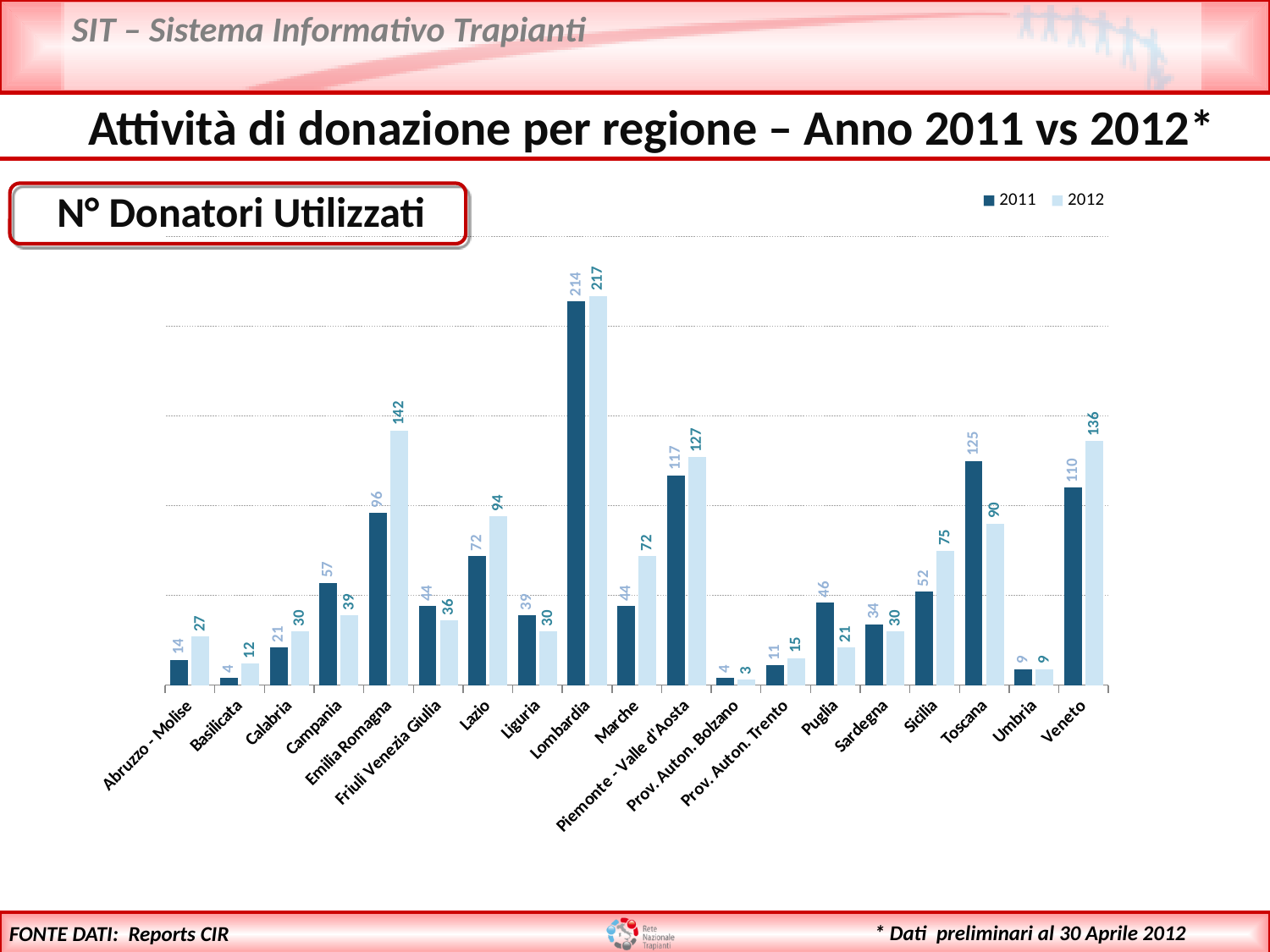
Which is larger for Sicilia, the 2011 value or the 2012 value? 2012 What is the difference between the 2012 and 2011 values for Veneto? 26 Which region has the highest 2012 value? Lombardia What is the 2012 value for Emilia Romagna? 142 How many series does the legend list? 2 Which region has the lowest 2012 value? Prov. Auton. Bolzano What is the 2012 value for Lazio? 94 What kind of chart is shown? Bar chart What is the 2011 value for Toscana? 125 How many regions are shown on the x axis? 19 What is the title shown in the box above the chart? N° Donatori Utilizzati Which is larger for Toscana, the 2011 value or the 2012 value? 2011